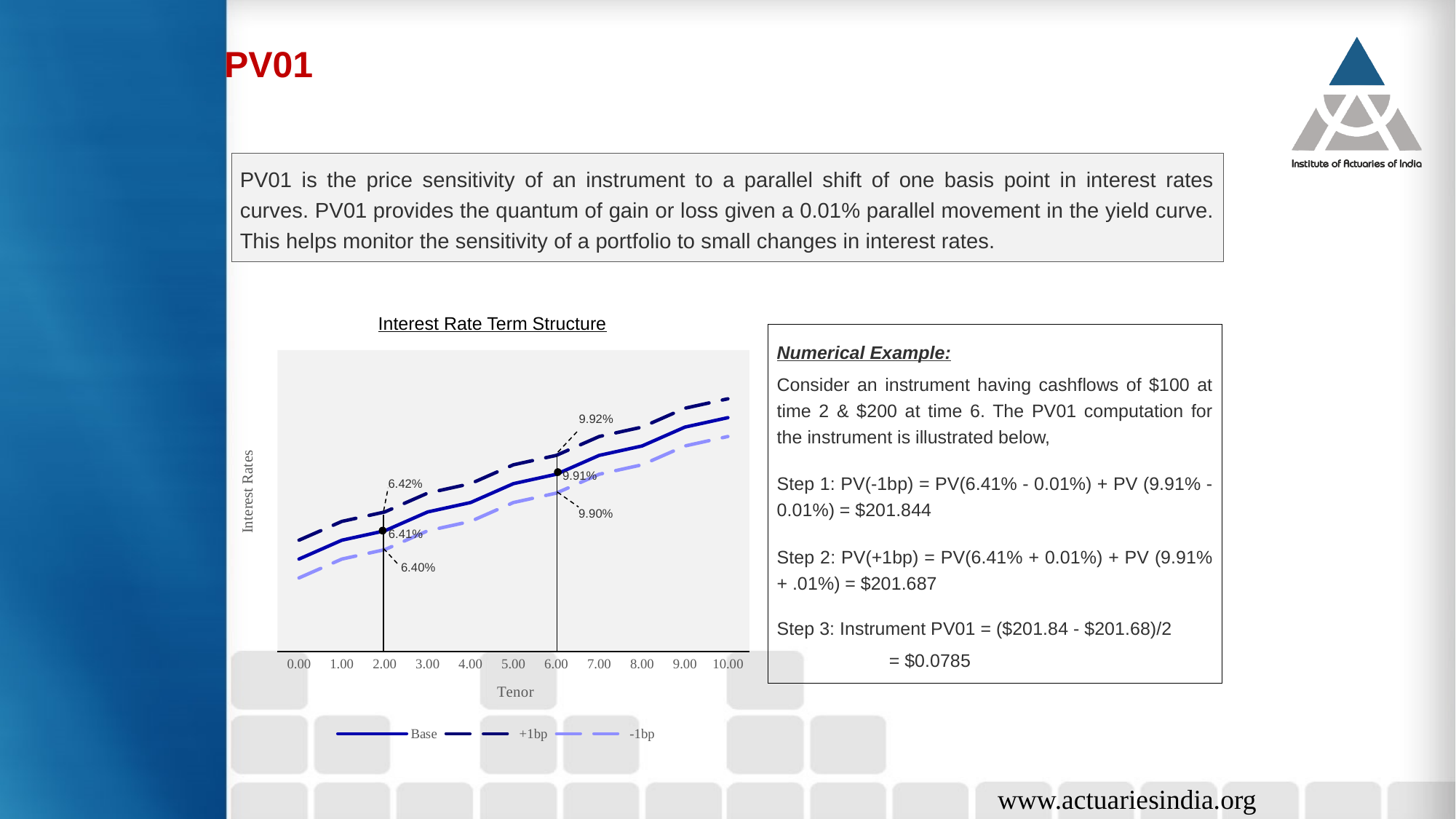
In the Interest Rate Term Structure chart, what is the difference between the +1bp rate and the -1bp rate at tenor 6.00? 0.02% What is the title of the chart on the slide? Interest Rate Term Structure In the Interest Rate Term Structure chart, what is the Base interest rate at tenor 6.00? 9.91% In the Interest Rate Term Structure chart, what is the difference between the Base rate at tenor 6.00 and the Base rate at tenor 2.00? 3.50% What is the title of the x axis of the Interest Rate Term Structure chart? Tenor In the Interest Rate Term Structure chart, what is the +1bp interest rate at tenor 6.00? 9.92% How many series does the legend of the Interest Rate Term Structure chart list? 3 In the Interest Rate Term Structure chart, do the interest rates rise or fall as tenor increases? rise What type of chart is the Interest Rate Term Structure chart? line chart In the Interest Rate Term Structure chart, what is the Base interest rate at tenor 2.00? 6.41% In the Interest Rate Term Structure chart, what is the -1bp interest rate at tenor 2.00? 6.40% In the Interest Rate Term Structure chart, which is larger at tenor 2.00: the +1bp rate or the -1bp rate? +1bp